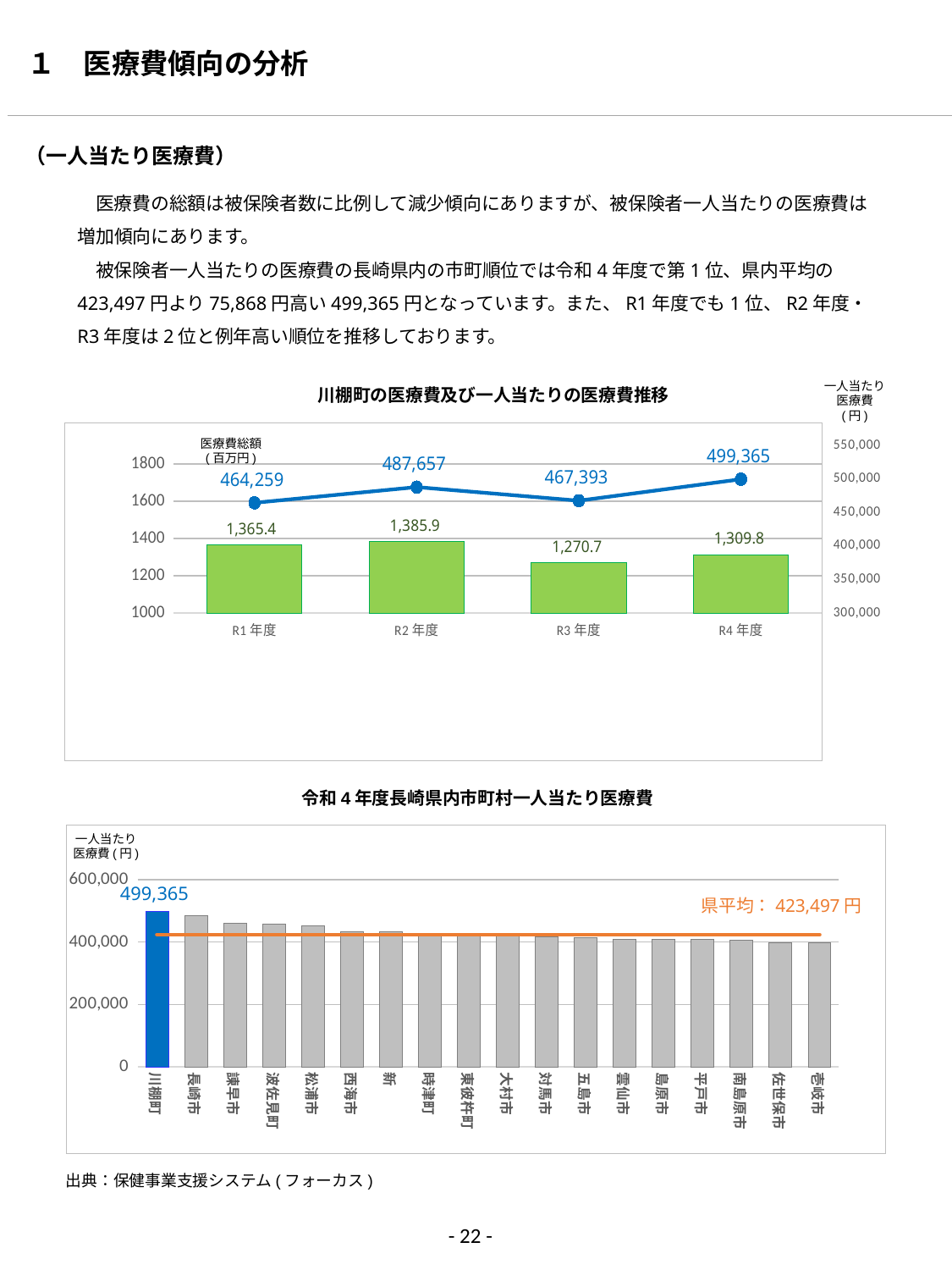
In the chart titled 川棚町の医療費及び一人当たりの医療費推移, what is the 一人当たり医療費 value for R4 年度? 499,365 In the chart titled 令和4年度長崎県内市町村一人当たり医療費, what kind of chart is used? bar chart In the chart titled 川棚町の医療費及び一人当たりの医療費推移, how many years are shown on the x axis? 4 In the chart titled 川棚町の医療費及び一人当たりの医療費推移, is the 医療費総額 for R1 年度 or R4 年度 larger? R1 年度 In the chart titled 令和4年度長崎県内市町村一人当たり医療費, what is the 県平均 value shown by the horizontal line? 423,497 円 In the chart titled 令和4年度長崎県内市町村一人当たり医療費, what is the value for 川棚町? 499,365 In the chart titled 川棚町の医療費及び一人当たりの医療費推移, what is the difference in 一人当たり医療費 between R4 年度 and R1 年度? 35,106 In the chart titled 川棚町の医療費及び一人当たりの医療費推移, which year has the lowest 医療費総額? R3 年度 In the chart titled 令和4年度長崎県内市町村一人当たり医療費, which municipality has the highest value? 川棚町 In the chart titled 川棚町の医療費及び一人当たりの医療費推移, which year has the highest 一人当たり医療費? R4 年度 In the chart titled 川棚町の医療費及び一人当たりの医療費推移, what is the 医療費総額 value for R2 年度? 1,385.9